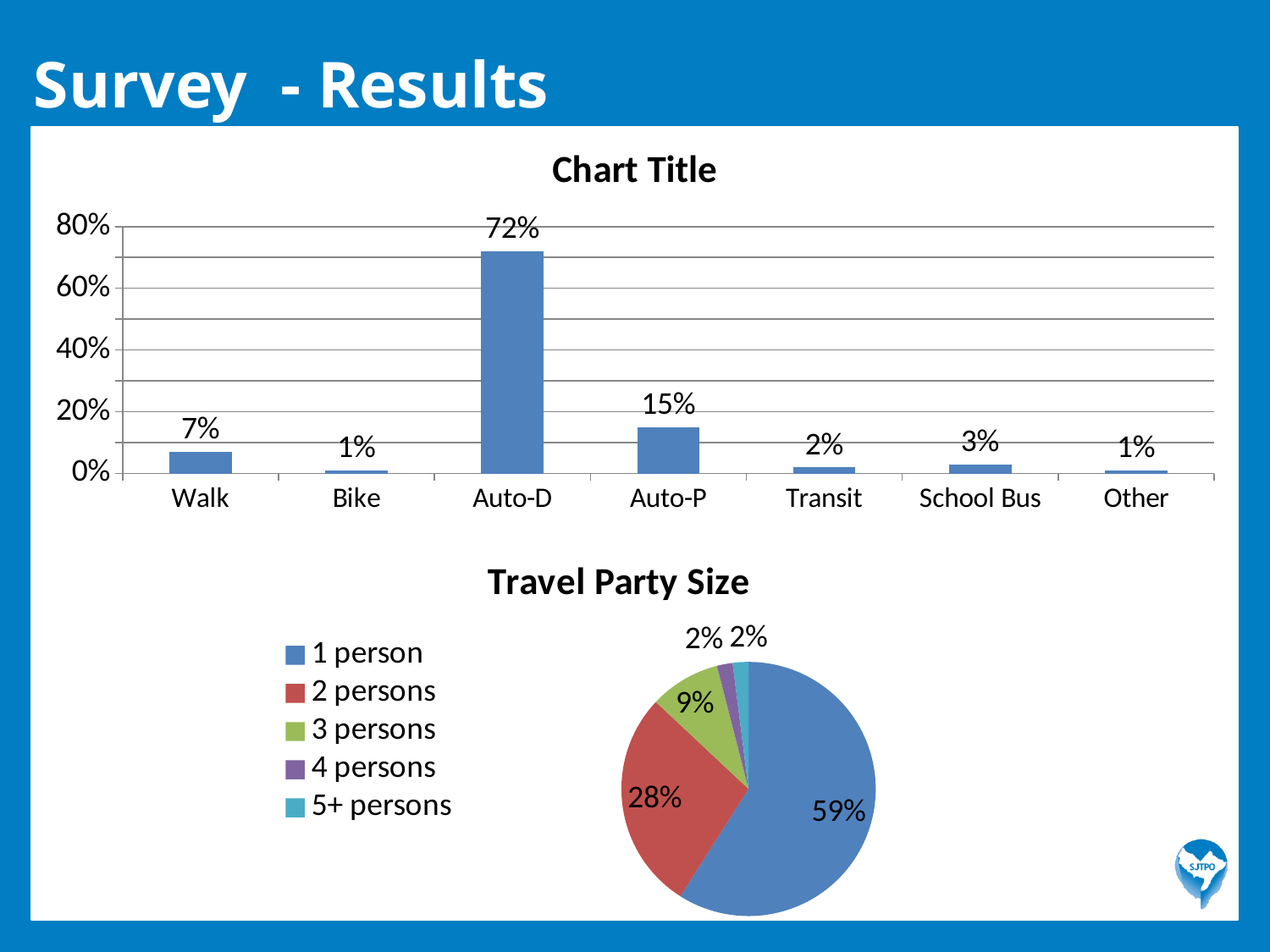
What kind of chart is the top chart on the slide? Bar chart In the Travel Party Size chart, which category has the smallest share, 3 persons or 2 persons? 3 persons In the bar chart titled "Chart Title", how many categories are shown on the x axis? 7 In the bar chart titled "Chart Title", what is the value for Walk? 7% In the Travel Party Size chart, what is the value for 2 persons? 28% In the bar chart titled "Chart Title", what is the value for Auto-D? 72% In the bar chart titled "Chart Title", which category has the highest value? Auto-D How many entries does the legend of the Travel Party Size chart list? 5 In the bar chart titled "Chart Title", which is larger, the value for Walk or the value for School Bus? Walk In the Travel Party Size chart, what share of the pie is 1 person? 59% What kind of chart is the Travel Party Size chart? Pie chart In the bar chart titled "Chart Title", what is the difference between the values for Auto-D and Auto-P? 57%